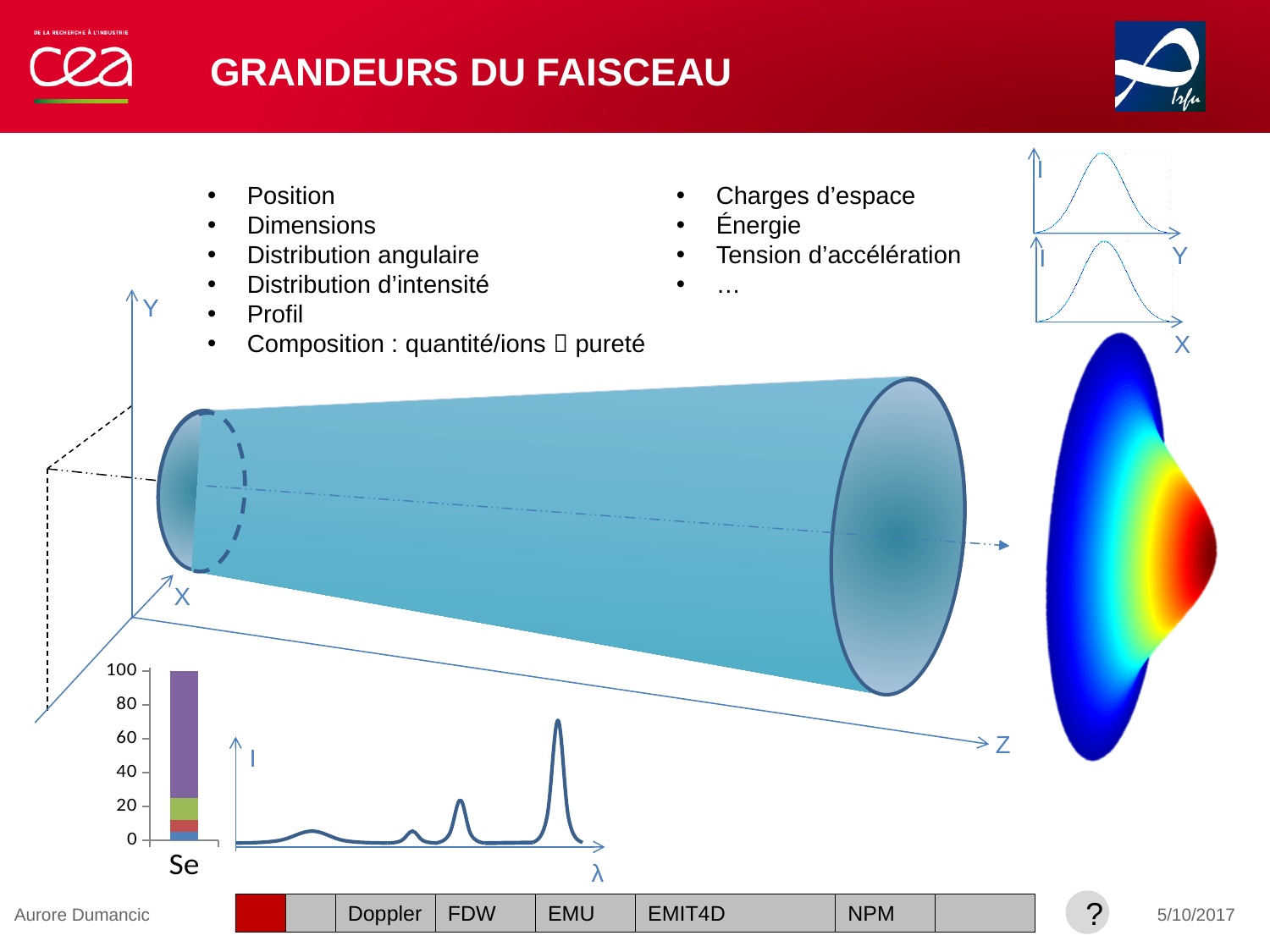
In the stacked bar chart at the bottom left, how many categories are plotted on the x axis? 1 In the stacked bar chart at the bottom left, what is the highest value shown on the y axis? 100 In the stacked bar chart at the bottom left, which coloured segment is the largest? purple In the stacked bar chart at the bottom left, what is the label of the single category on the x axis? Se In the stacked bar chart at the bottom left, is the top of the stacked bar greater or less than 80? greater In the stacked bar chart at the bottom left, how many coloured segments make up the bar? 4 In the stacked bar chart at the bottom left, is the top of the green segment greater or less than 40? less In the stacked bar chart at the bottom left, is the purple segment larger or smaller than the blue segment? larger What kind of chart is shown at the bottom left of the slide, above the label "Se"? stacked bar chart